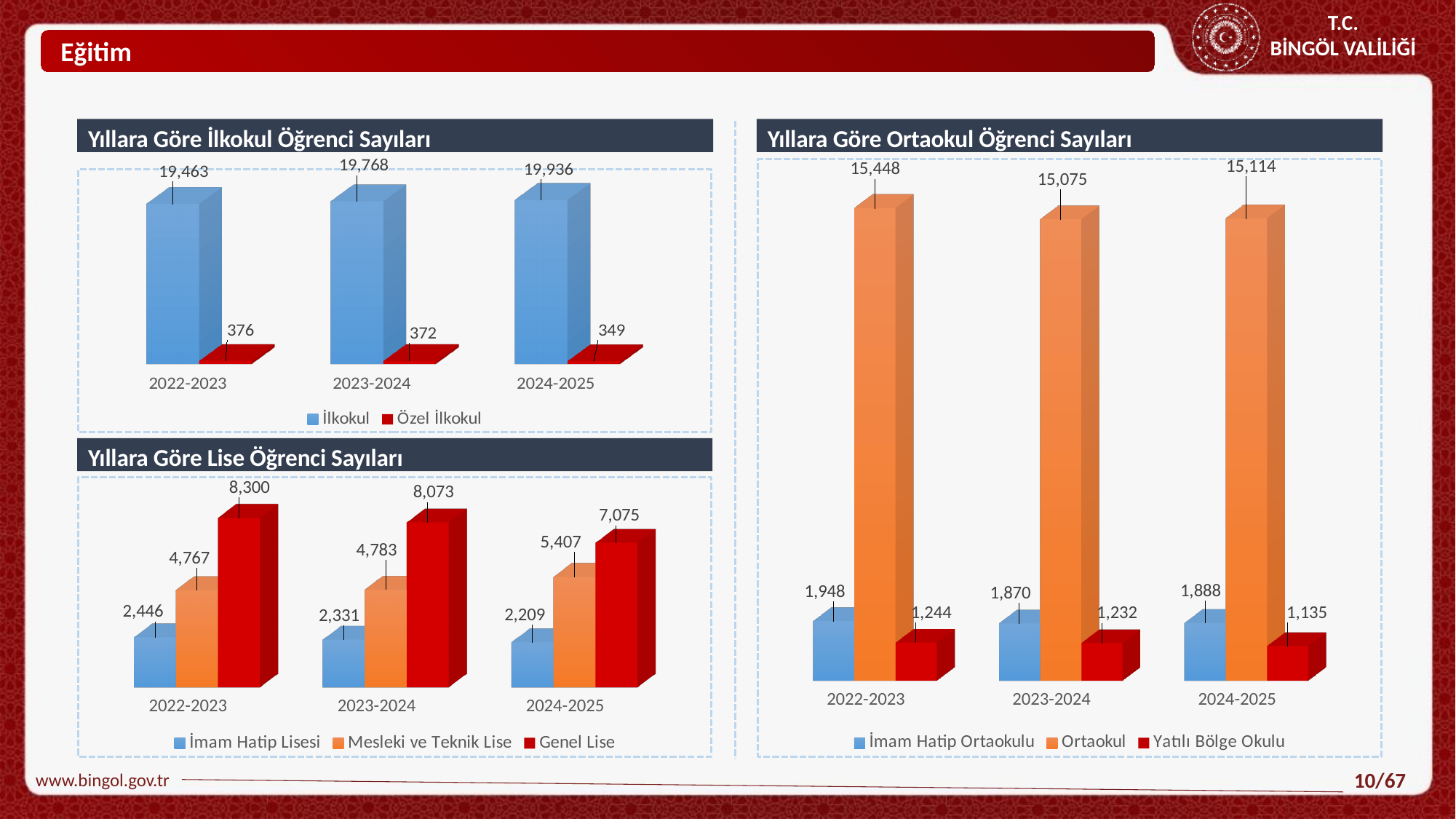
In the 'Yıllara Göre İlkokul Öğrenci Sayıları' chart, does the İlkokul series rise or fall from 2022-2023 to 2024-2025? rise In the 'Yıllara Göre Ortaokul Öğrenci Sayıları' chart, which is larger for 2022-2023: İmam Hatip Ortaokulu or Yatılı Bölge Okulu? İmam Hatip Ortaokulu In the 'Yıllara Göre Ortaokul Öğrenci Sayıları' chart, which year has the lowest Yatılı Bölge Okulu value? 2024-2025 In the 'Yıllara Göre İlkokul Öğrenci Sayıları' chart, what is the Özel İlkokul value for 2022-2023? 376 In the 'Yıllara Göre Lise Öğrenci Sayıları' chart, does the Genel Lise series rise or fall across the years? fall In the 'Yıllara Göre İlkokul Öğrenci Sayıları' chart, what is the İlkokul value for 2024-2025? 19,936 In the 'Yıllara Göre Lise Öğrenci Sayıları' chart, how many series does the legend list? 3 In the 'Yıllara Göre Lise Öğrenci Sayıları' chart, what is the Genel Lise value for 2022-2023? 8,300 What kind of chart is 'Yıllara Göre Ortaokul Öğrenci Sayıları'? bar chart In the 'Yıllara Göre İlkokul Öğrenci Sayıları' chart, what is the difference between the İlkokul and Özel İlkokul values for 2023-2024? 19,396 In the 'Yıllara Göre Lise Öğrenci Sayıları' chart, which year has the highest Mesleki ve Teknik Lise value? 2024-2025 In the 'Yıllara Göre Ortaokul Öğrenci Sayıları' chart, what is the Ortaokul value for 2023-2024? 15,075